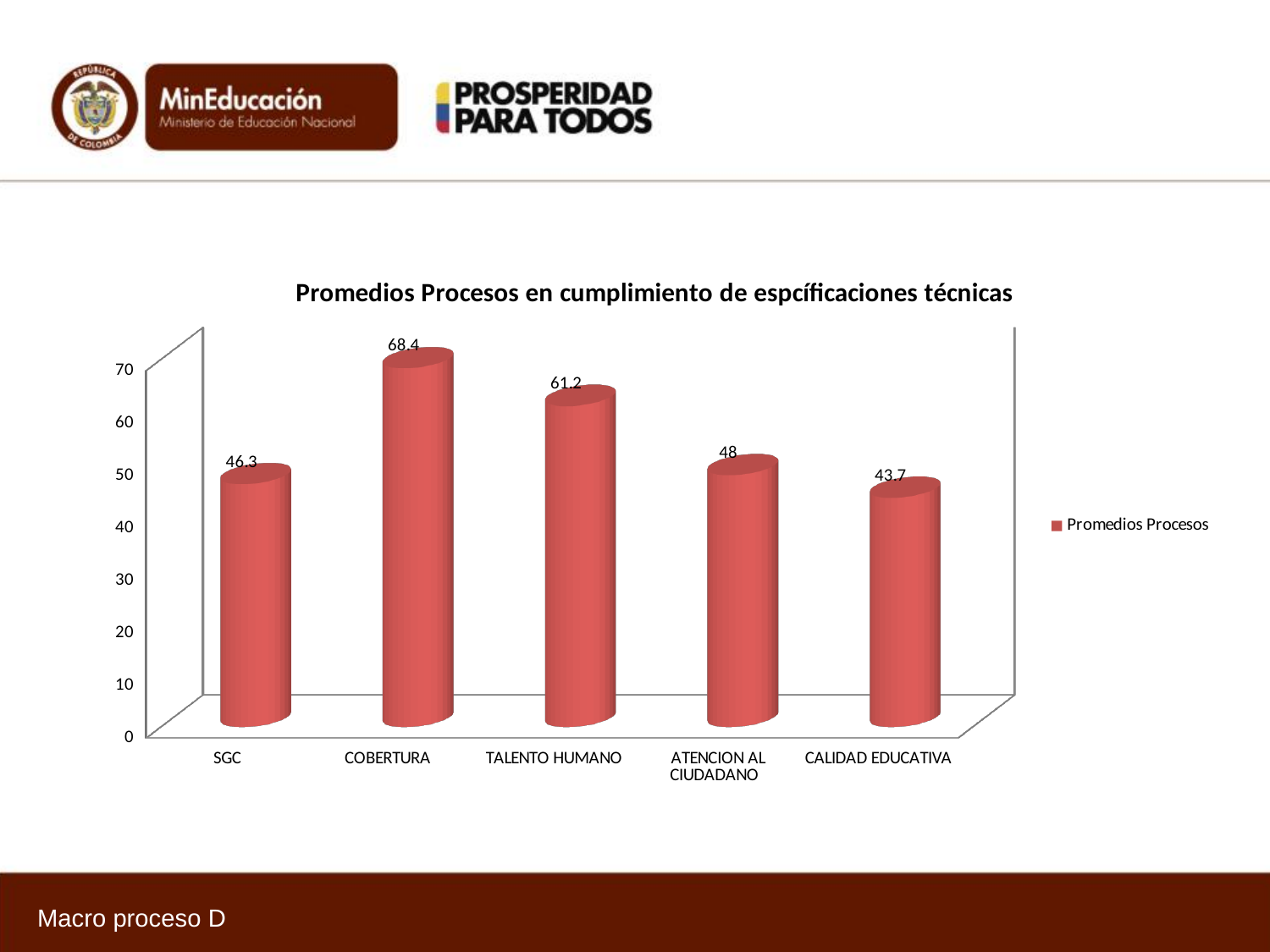
What is the difference between the values for COBERTURA and TALENTO HUMANO? 7.2 Which is larger, the value for SGC or the value for ATENCION AL CIUDADANO? ATENCION AL CIUDADANO What is the value for ATENCION AL CIUDADANO? 48 Is the value for TALENTO HUMANO greater or less than 50? greater How many categories are shown on the x axis? 5 What is the value for SGC? 46.3 What kind of chart is shown on the slide? bar chart Which category has the highest value? COBERTURA What is the value for CALIDAD EDUCATIVA? 43.7 What is the value for COBERTURA? 68.4 Which category has the lowest value? CALIDAD EDUCATIVA What series name does the legend list? Promedios Procesos